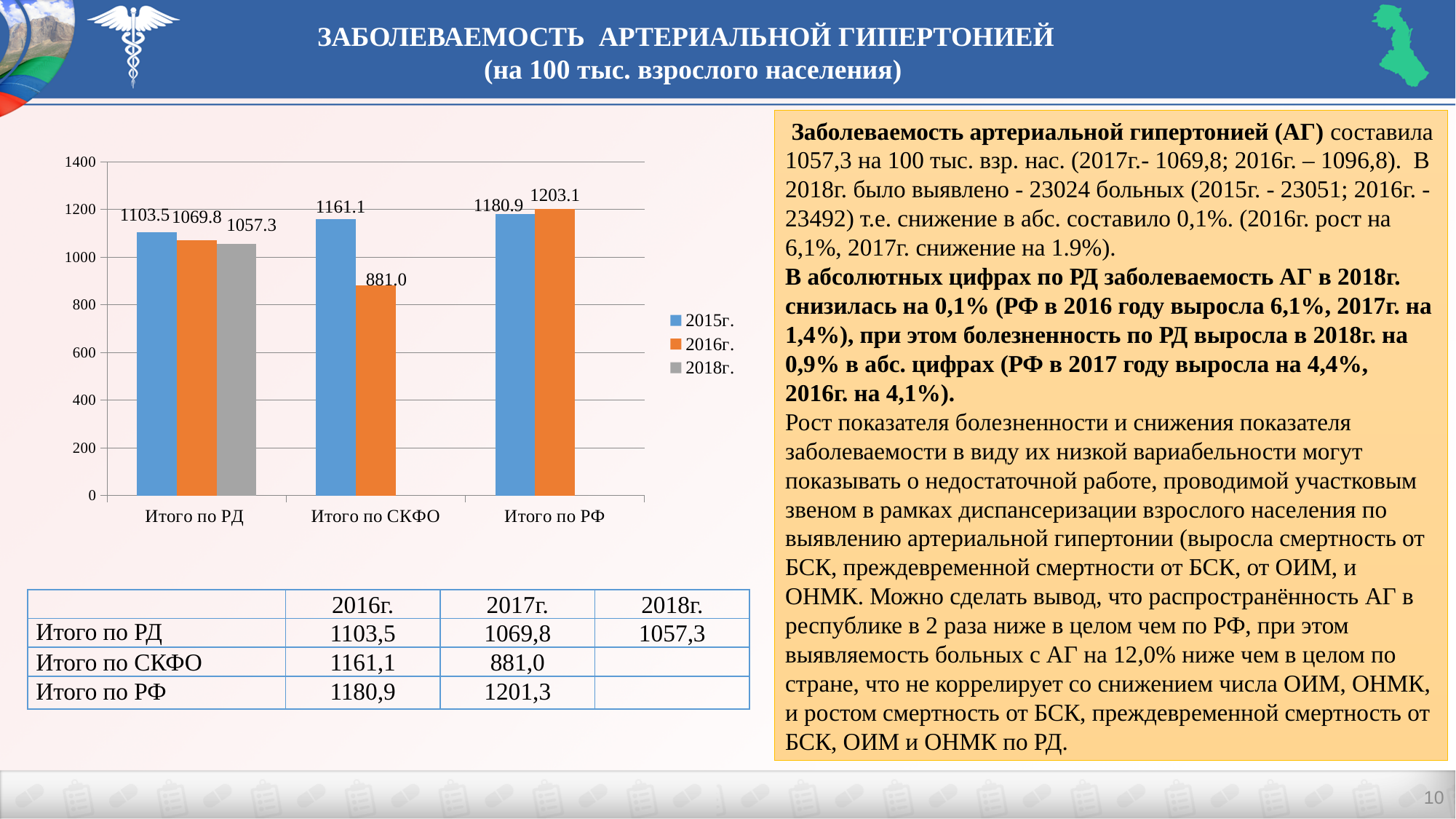
Which category has the lowest 2016г. value in the chart? Итого по СКФО How many series does the chart legend list? 3 Which category in the chart has a bar for the 2018г. series? Итого по РД How many categories are shown on the x axis of the chart? 3 What is the value of the 2016г. series for Итого по СКФО in the chart? 881.0 Which is larger in the chart: the 2015г. value for Итого по РФ or the 2016г. value for Итого по РФ? 2016г. What is the value of the 2016г. series for Итого по РФ in the chart? 1203.1 Which category has the highest 2015г. value in the chart? Итого по РФ What type of chart is shown on the slide? bar chart What is the value of the 2015г. series for Итого по РД in the chart? 1103.5 What is the value of the 2018г. series for Итого по РД in the chart? 1057.3 What is the difference between the 2015г. and 2016г. values for Итого по СКФО in the chart? 280.1